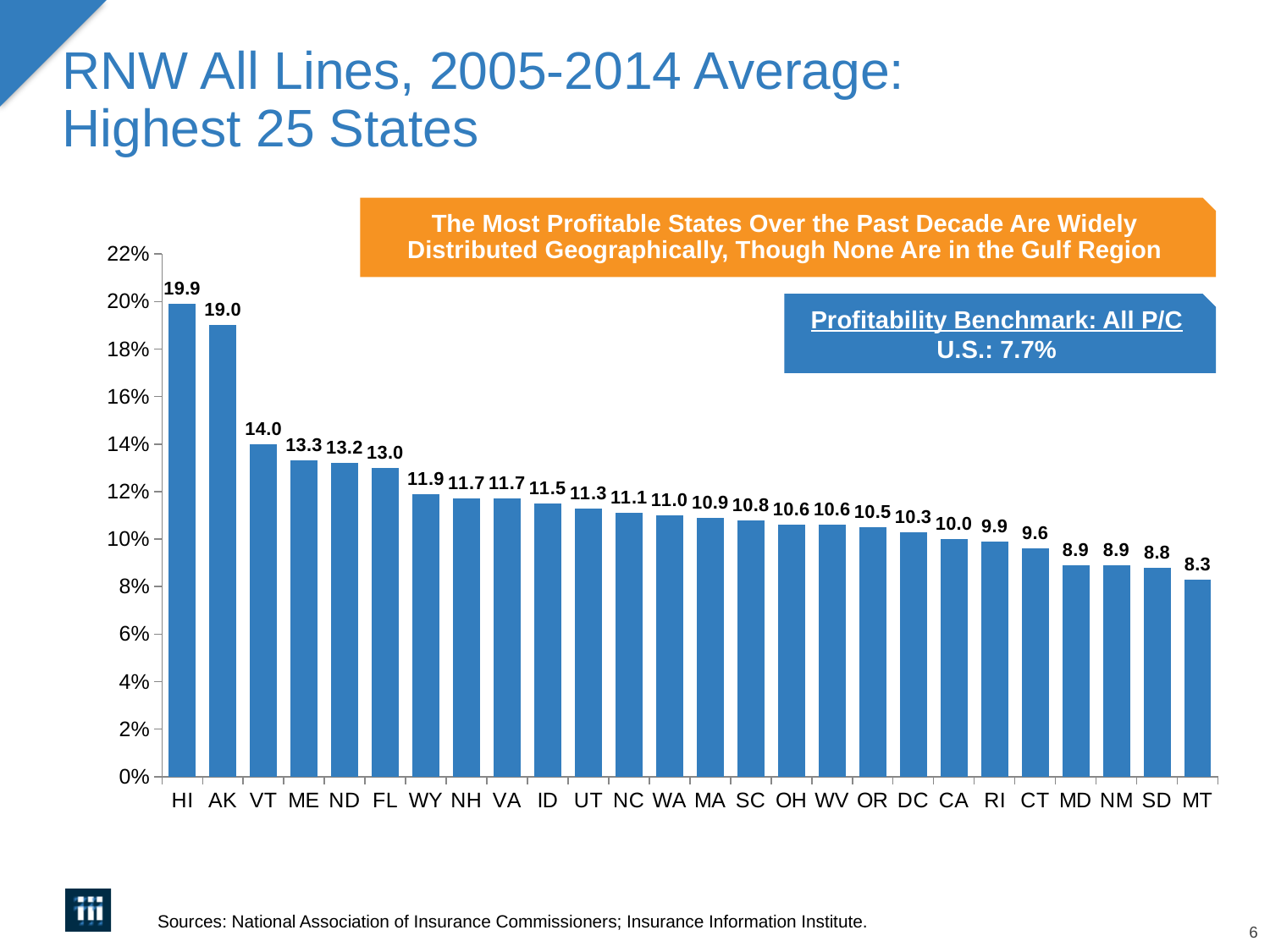
What is the value shown for HI? 19.9 What is the difference between the values for VT and MT? 5.7 What profitability benchmark for all P/C U.S. is stated on the slide? 7.7% How many bars are plotted on the chart? 26 Is the value for AK greater or less than 18%? greater What is the value shown for CA? 10.0 What is the difference between the values for HI and AK? 0.9 Which has a larger value, ME or WY? ME What kind of chart is shown on the slide? Bar chart What is the value shown for FL? 13.0 Which category has the lowest value on the chart? MT Which state has the highest value on the chart? HI